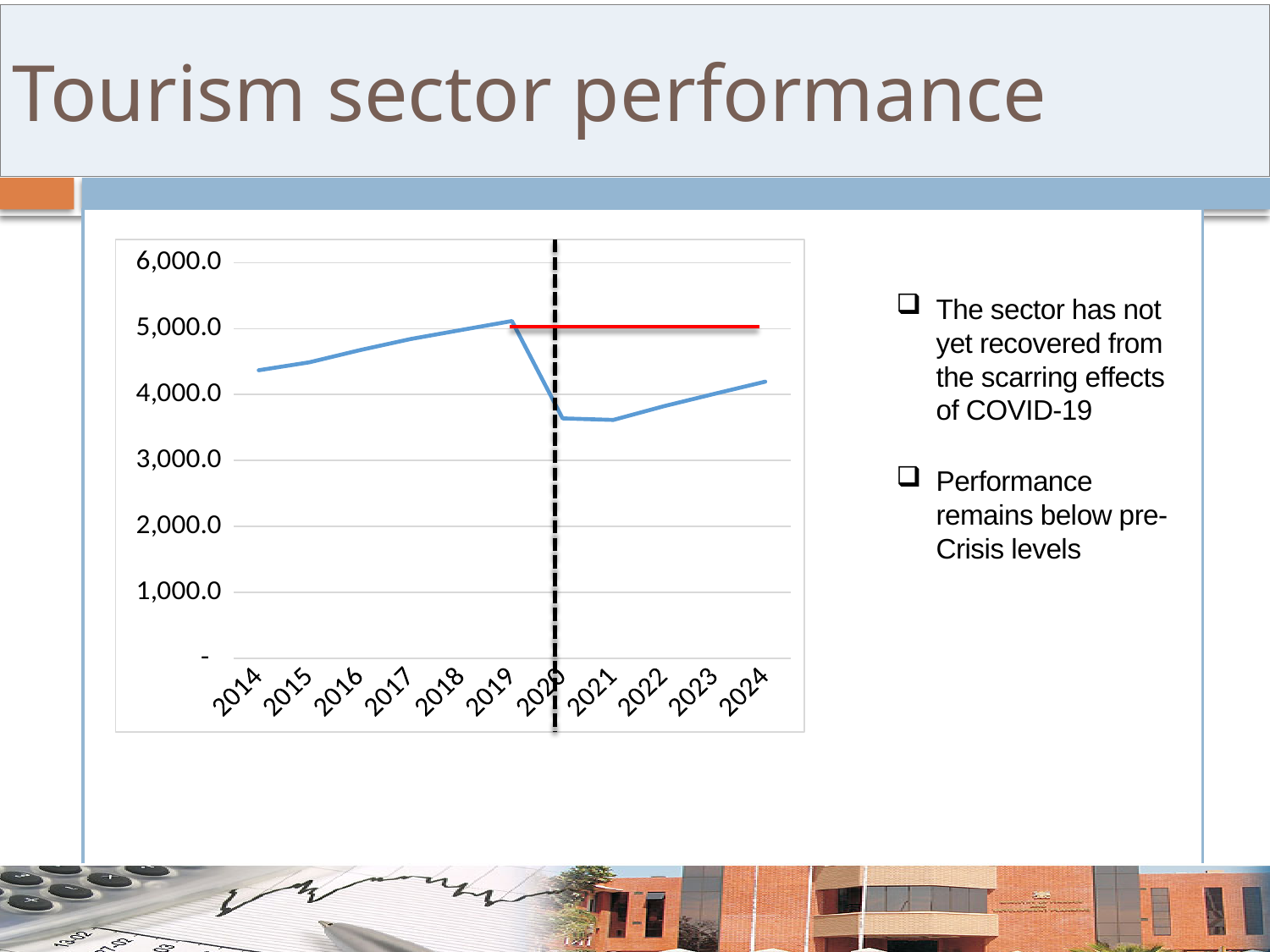
Is the value for 2024 greater or less than 5,000.0? less Is the value for 2020 greater or less than 3,000.0? greater Which year has the highest value on the chart? 2019 What kind of chart is shown on the slide? line chart Do the values rise or fall from 2014 to 2019? rise Which year has the larger value, 2014 or 2020? 2014 Is the value for 2019 greater or less than 5,000.0? greater Which year has the larger value, 2019 or 2024? 2019 How many years are plotted along the x axis of the chart? 11 At which year is the vertical dashed black line drawn on the chart? 2020